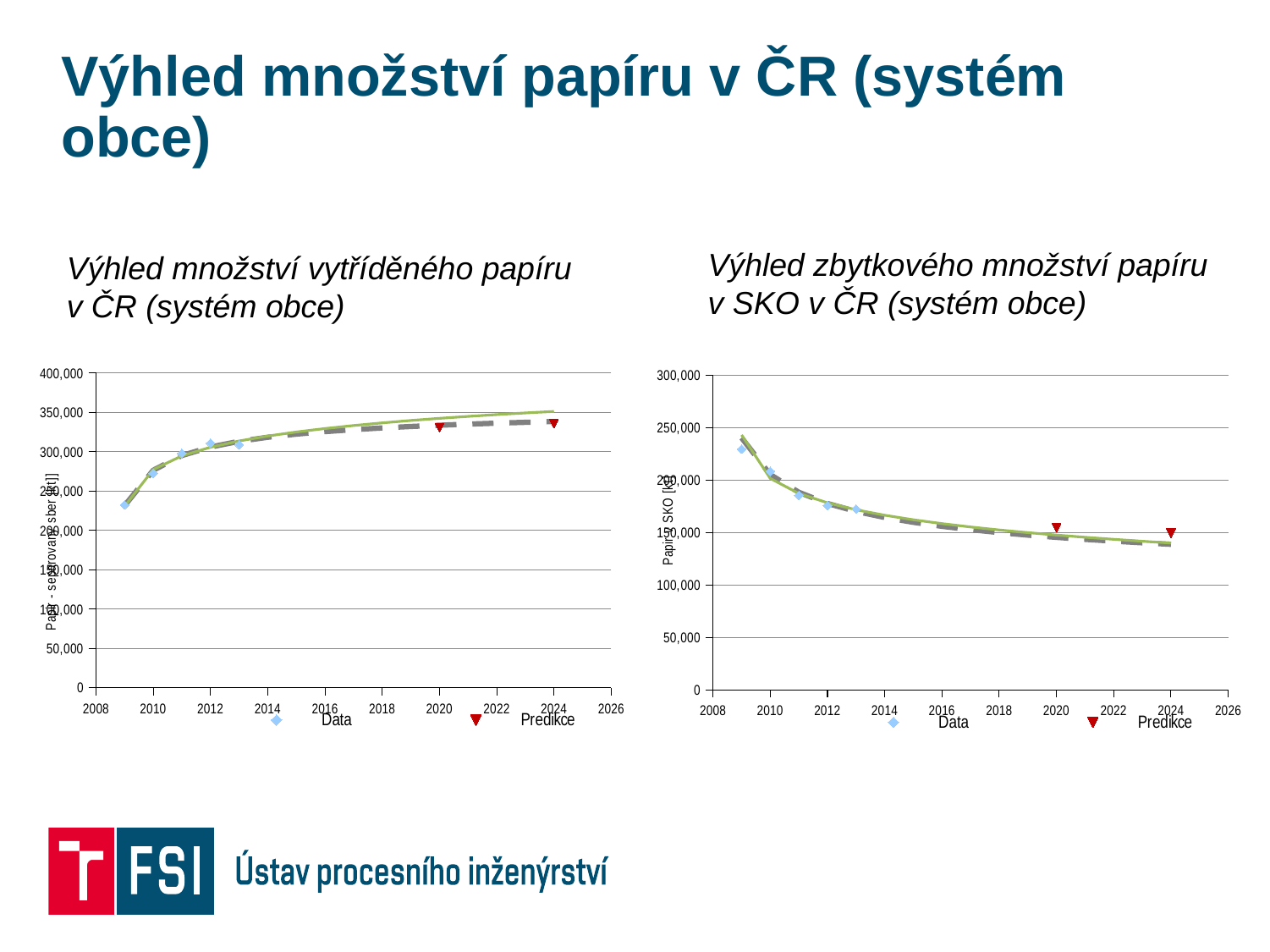
In the right chart, 'Výhled zbytkového množství papíru v SKO v ČR', do the values rise or fall from 2009 to 2024? fall In the left chart, how many 'Data' points (blue diamonds) are plotted? 5 What are the two legend entries in the right chart? Data, Predikce In the left chart, is the 'Predikce' value for 2024 greater or less than 300,000? greater In the right chart, how many 'Predikce' points (red triangles) are plotted? 2 In the right chart, which year has the highest 'Data' value, 2009 or 2013? 2009 In the left chart, is the 'Data' value for 2009 greater or less than 200,000? greater How many series does the legend of the left chart list? 2 What kind of chart is the left chart, 'Výhled množství vytříděného papíru v ČR (systém obce)'? line chart In the right chart, is the 'Data' value for 2013 greater or less than 200,000? less In the left chart, 'Výhled množství vytříděného papíru v ČR', do the values rise or fall from 2009 to 2024? rise